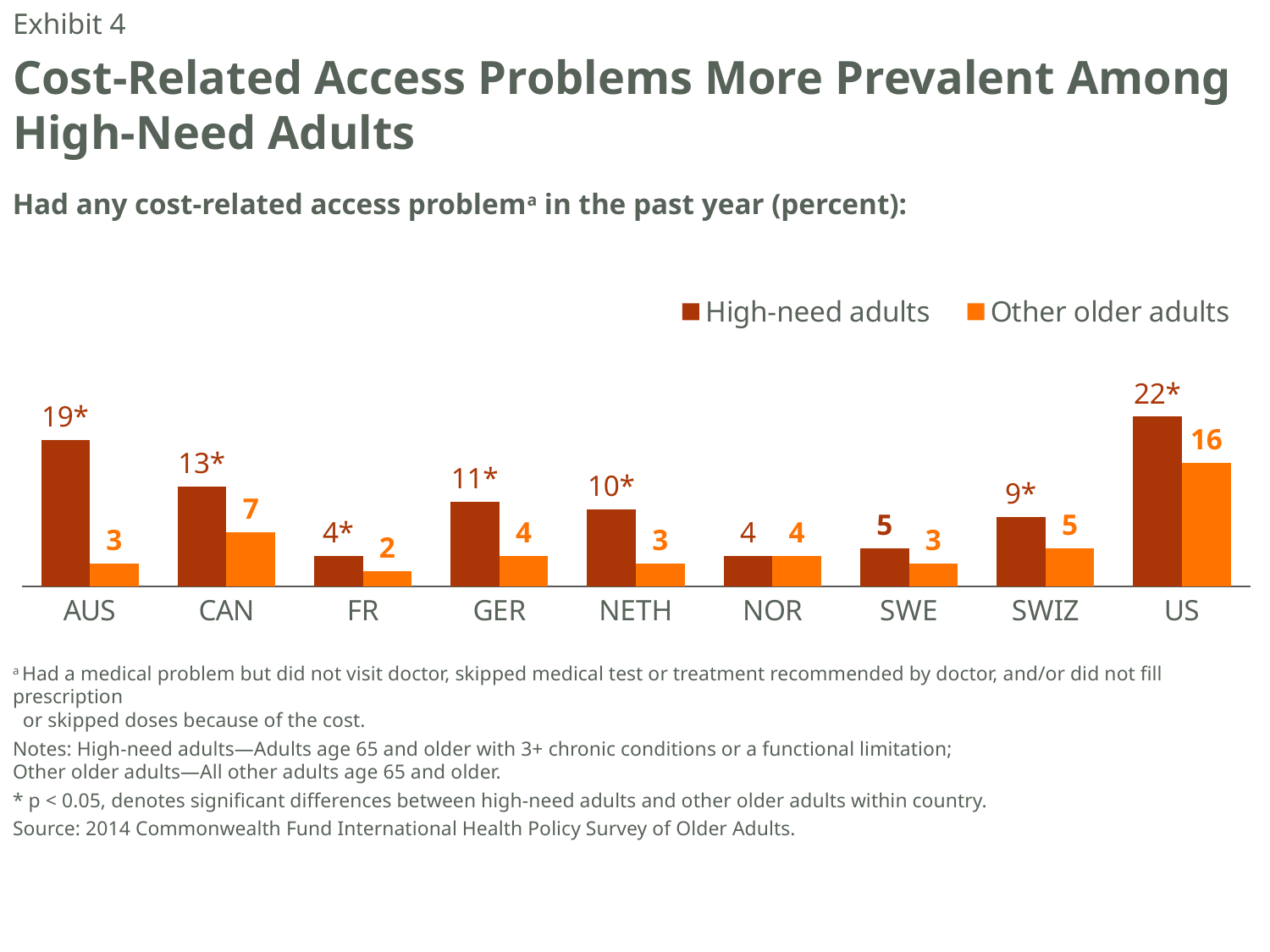
What is the value for High-need adults in NETH? 10* What is the difference between High-need adults and Other older adults in the US? 6 How many countries are shown on the x axis? 9 What is the value for High-need adults in the US? 22* Which country has the lowest value for Other older adults? FR Which series is shown in dark red-brown in the legend? High-need adults What is the difference between High-need adults and Other older adults in AUS? 16 Which country has the highest value for High-need adults? US How many series does the legend list? 2 Which is larger in GER: the value for High-need adults or for Other older adults? High-need adults What kind of chart is shown on the slide? Bar chart What is the value for Other older adults in CAN? 7